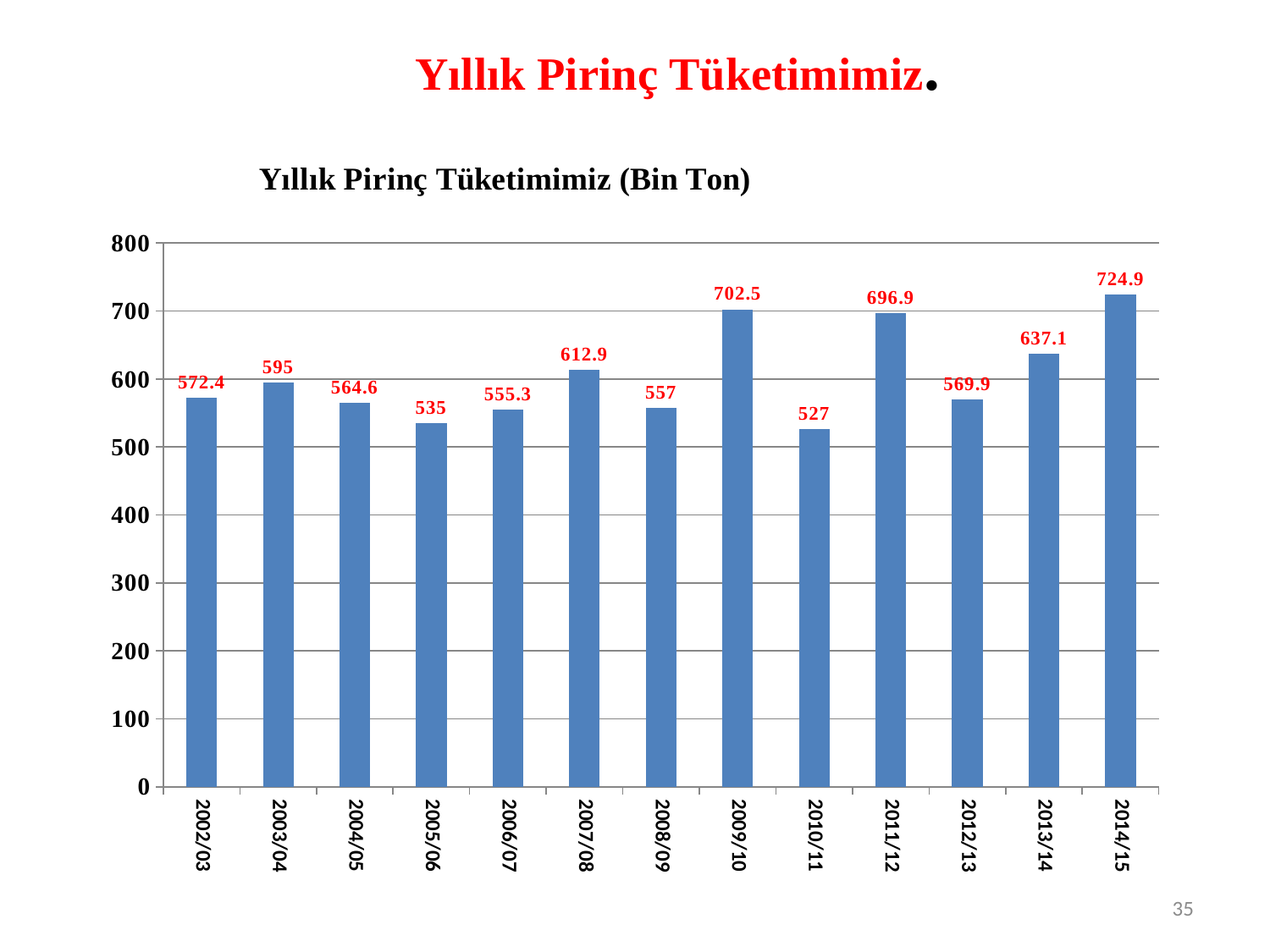
What is the value for 2005/06? 535 How many years are shown on the x axis? 13 What is the value for 2009/10? 702.5 What is the difference between the values for 2014/15 and 2010/11? 197.9 What is the title of the chart? Yıllık Pirinç Tüketimimiz (Bin Ton) Which is larger, the value for 2011/12 or the value for 2013/14? 2011/12 Which year has the lowest value? 2010/11 What is the value for 2013/14? 637.1 What kind of chart is this? bar chart Is the value for 2007/08 greater or less than 600? greater What is the difference between the values for 2009/10 and 2008/09? 145.5 Which year has the highest value? 2014/15